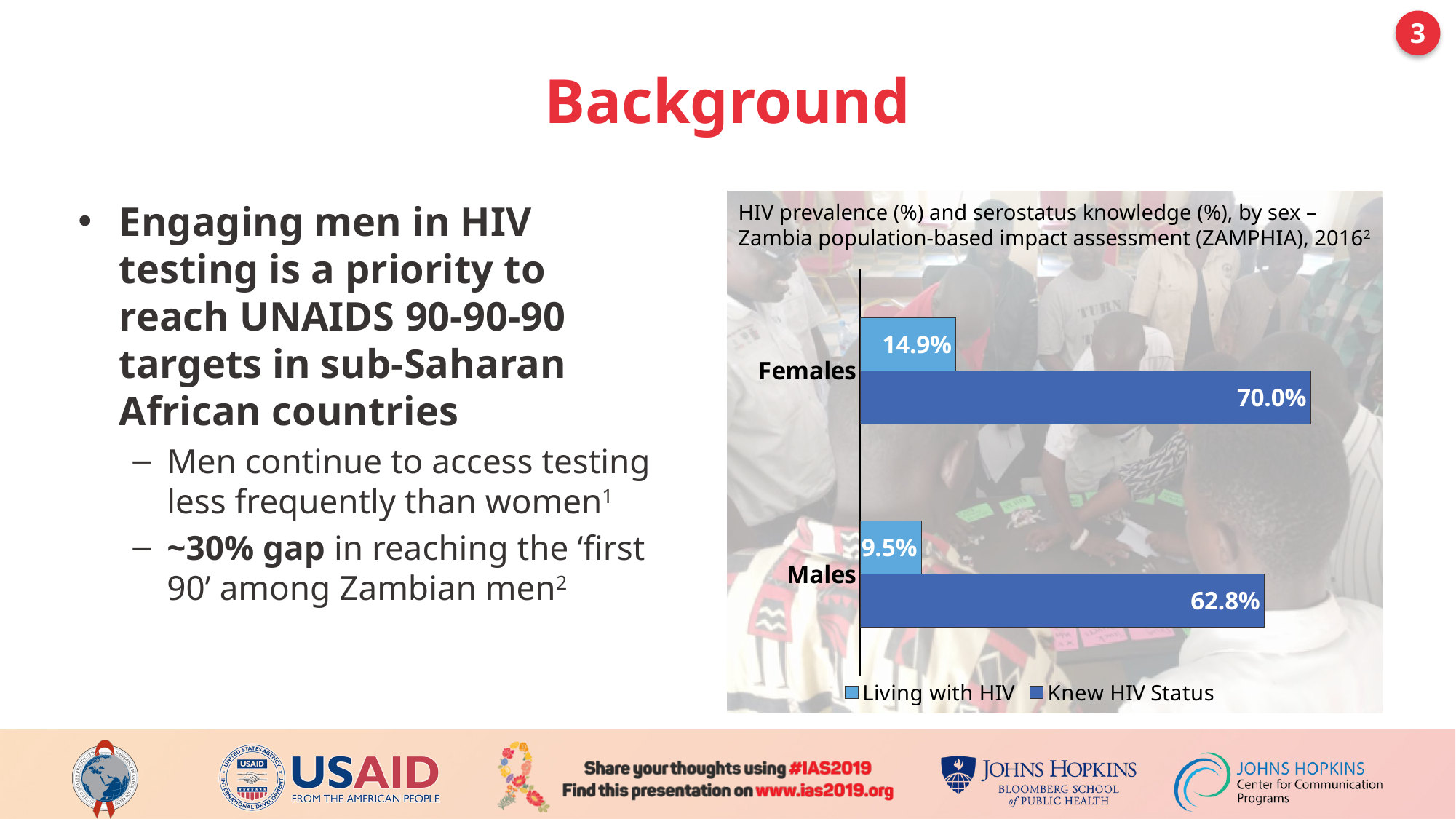
What is the value for females in the 'Knew HIV Status' series? 70.0% What type of chart is shown on the slide? Bar chart How many series does the chart legend list? 2 What is the difference between the 'Living with HIV' values for females and males? 5.4% How many categories (sexes) are shown on the chart? 2 What percentage of females are living with HIV according to the chart? 14.9% What is the value for males in the 'Living with HIV' series? 9.5% Which sex has the higher value for 'Knew HIV Status'? Females What percentage of males knew their HIV status according to the chart? 62.8% Which sex has the lower value for 'Living with HIV'? Males Is the 'Living with HIV' value larger for females or for males? Females What is the difference between the 'Knew HIV Status' values for females and males? 7.2%